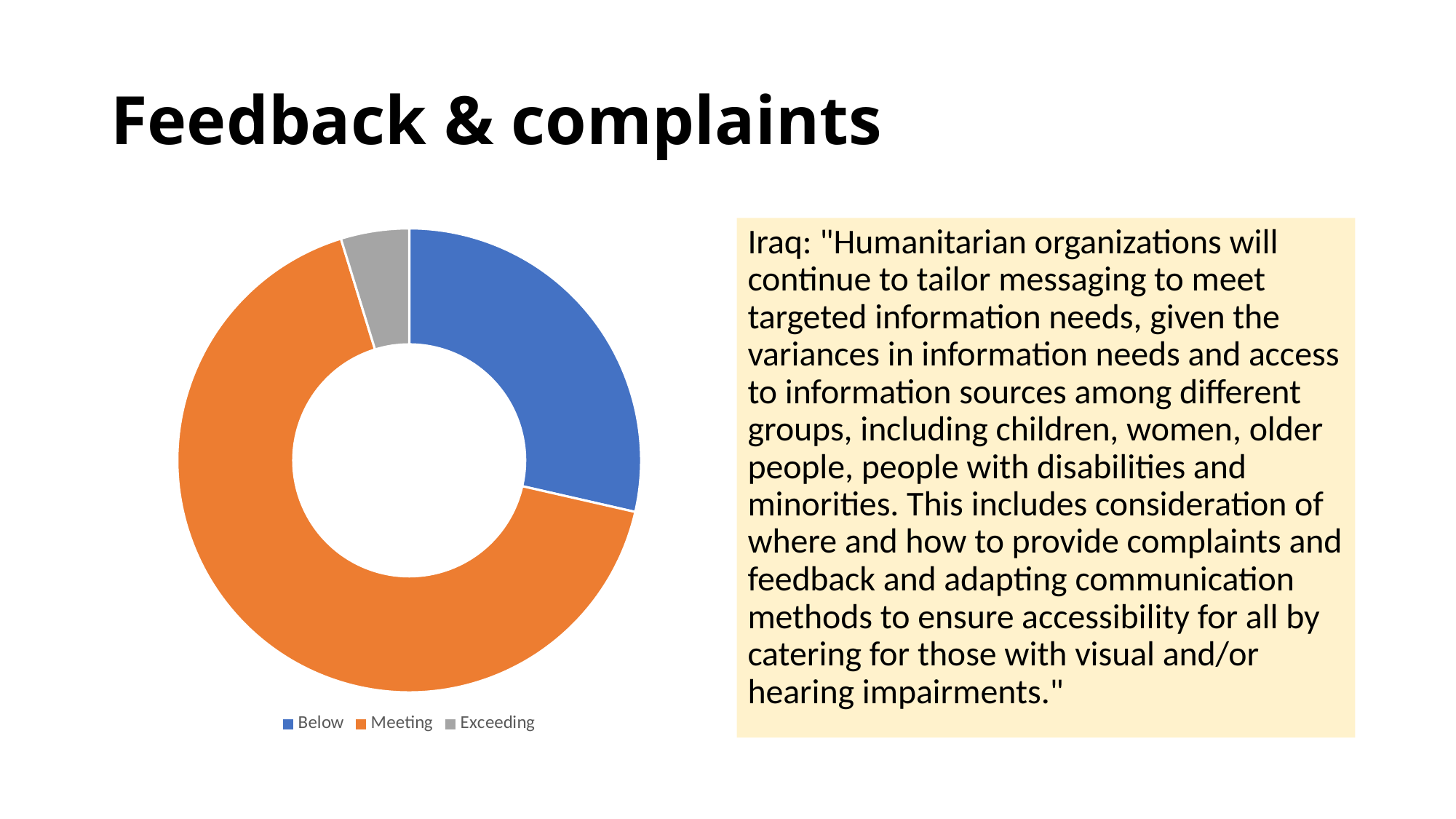
Is the share of the Meeting category greater or less than 50%? greater What colour represents the Meeting category in the chart? Orange Which category has a larger share, Below or Meeting? Meeting Is the share of the Below category greater or less than 50%? less Which category has a larger share, Below or Exceeding? Below Is the share of the Exceeding category greater or less than 25%? less How many categories does the chart's legend list? 3 What kind of chart is shown on the slide? Doughnut chart What colour represents the Exceeding category in the chart? Grey Which category has the largest share of the doughnut chart? Meeting Which category has the smallest share of the doughnut chart? Exceeding